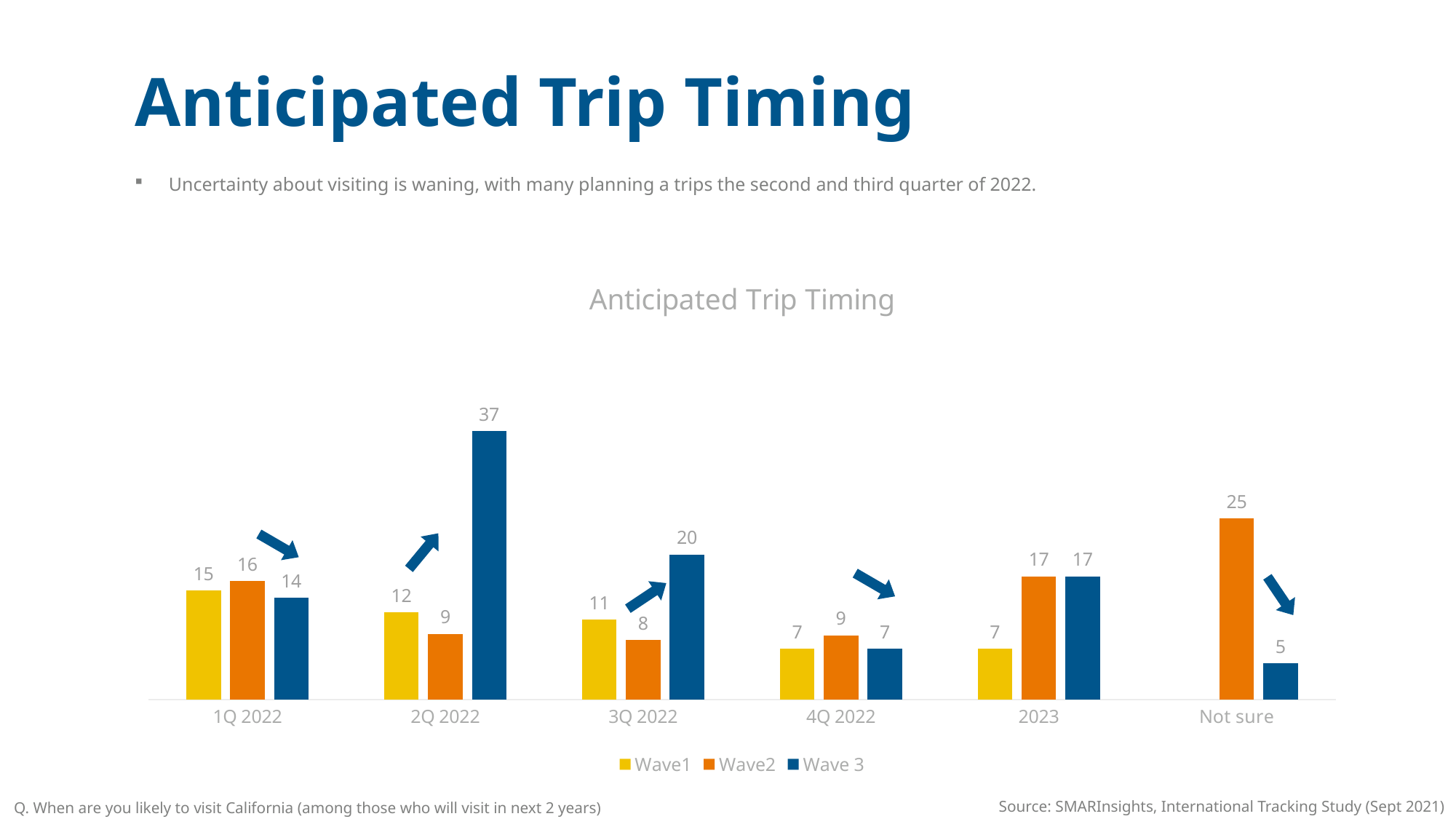
How many categories are shown on the x axis? 6 What is the difference between the Wave 3 and Wave2 values for 2Q 2022? 28 What is the title of the chart? Anticipated Trip Timing Which category has the highest Wave 3 value? 2Q 2022 What is the Wave 3 value for 2Q 2022? 37 Which is larger for Not sure: the Wave2 value or the Wave 3 value? Wave2 How many series does the legend list? 3 What kind of chart is shown on the slide? Bar chart Which category has the lowest Wave 3 value? Not sure What is the Wave1 value for 3Q 2022? 11 What is the difference between the Wave2 and Wave 3 values for Not sure? 20 What is the Wave2 value for Not sure? 25